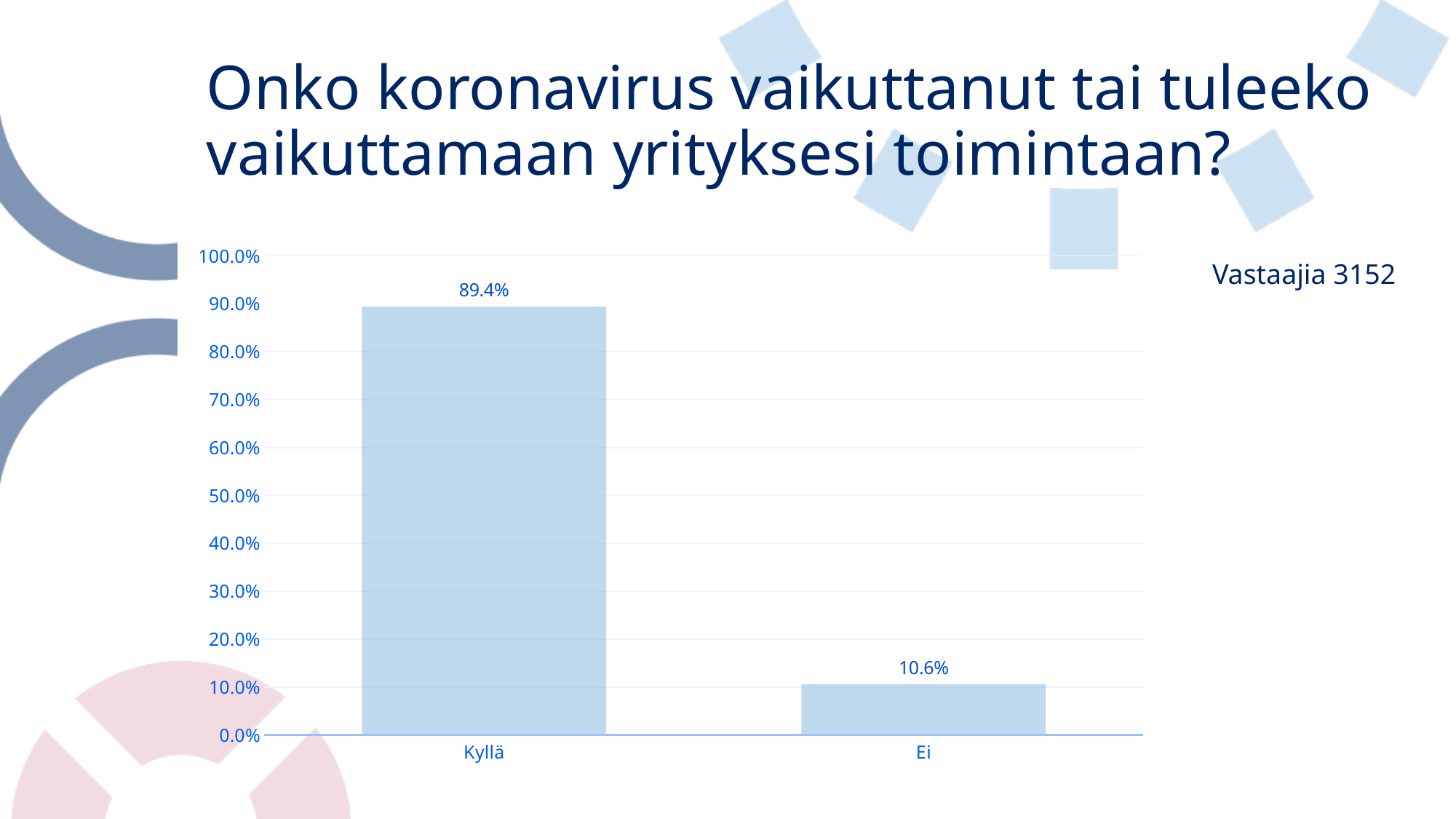
How many respondents (Vastaajia) are stated on the slide? 3152 Which is larger, the value for Kyllä or the value for Ei? Kyllä Is the value for Ei greater or less than 20.0%? less Which category has the highest value? Kyllä What is the value for Ei? 10.6% Which category has the lowest value? Ei What is the difference between the values for Kyllä and Ei? 78.8% What is the value for Kyllä? 89.4% Is the value for Kyllä greater or less than 80.0%? greater What is the total of the values for Kyllä and Ei? 100.0% What kind of chart is shown on the slide? bar chart How many categories are shown on the x axis? 2